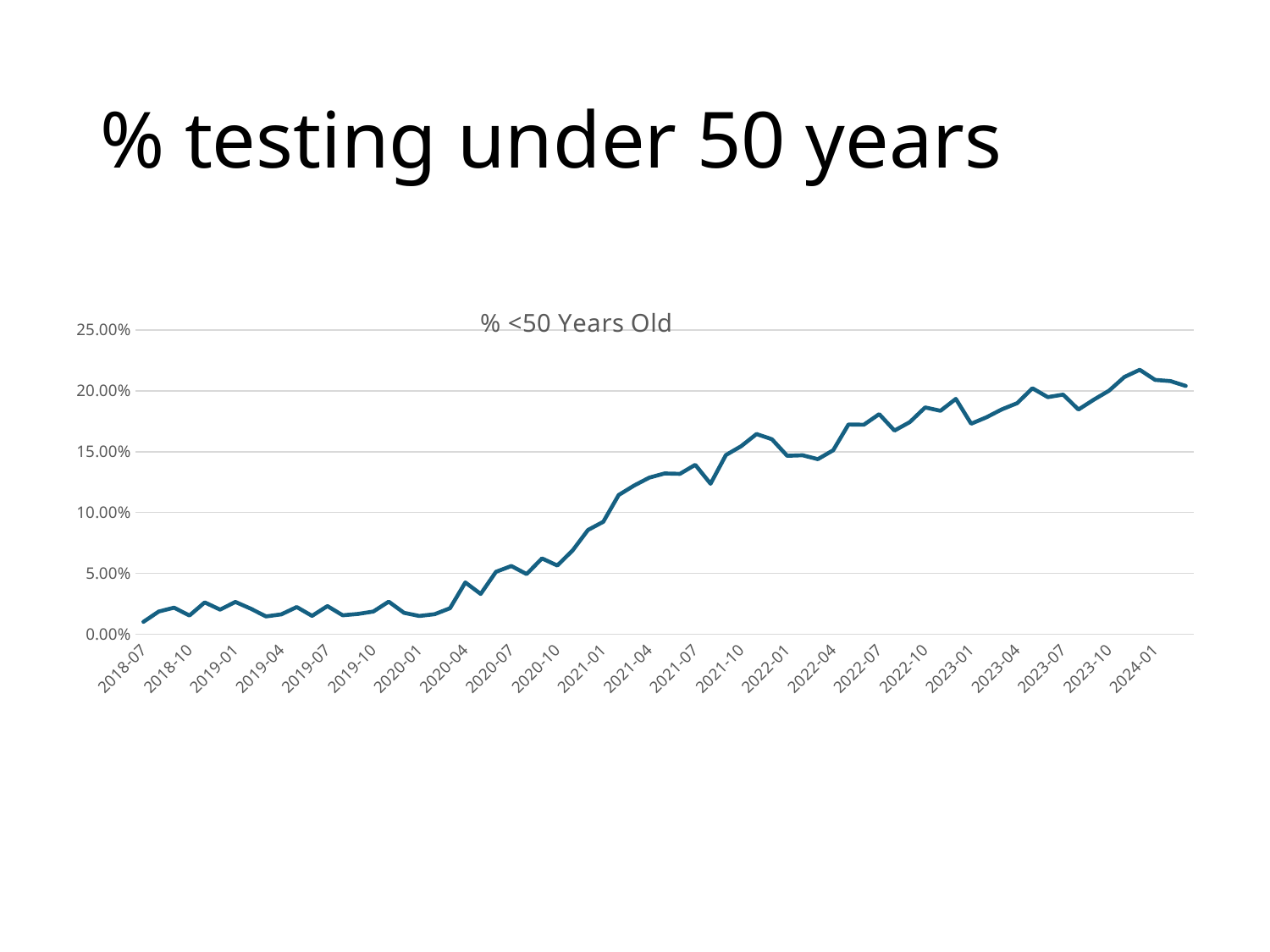
Is the value for 2021-04 greater or less than 10.00%? greater Do the values generally rise or fall from 2018-07 to 2024-01? rise Is the value for 2024-01 greater or less than 20.00%? greater Is the value for 2022-07 greater or less than 15.00%? greater Which is larger, the value for 2024-01 or the value for 2018-07? 2024-01 What kind of chart is shown on the slide? line chart How many date labels are shown along the x axis? 23 Which is larger, the value for 2019-07 or the value for 2022-01? 2022-01 What is the title shown above the plotted line? % <50 Years Old